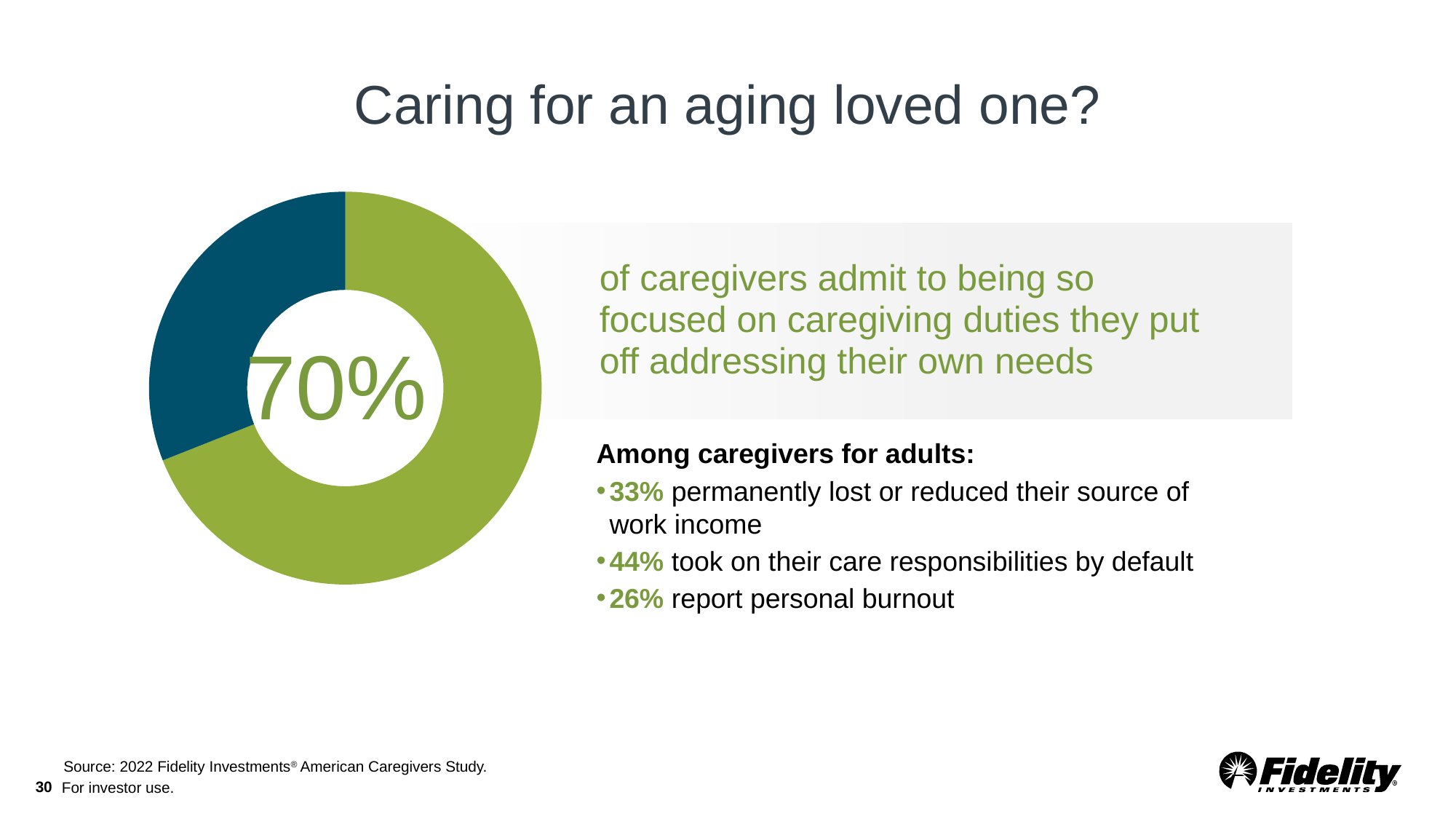
How many slices does the donut chart have? 2 Is the green slice of the donut chart greater or less than half of the whole? greater What kind of chart is shown on the left of the slide? Donut (pie) chart Is the dark blue slice of the donut chart greater or less than half of the whole? less What colour is the larger slice of the donut chart? Green What percentage is displayed in the centre of the donut chart? 70% Which slice of the donut chart is larger, the green one or the dark blue one? The green one What share of the donut chart does the green slice represent? 70% According to the slide, what does the 70% in the donut chart represent? Caregivers who admit to being so focused on caregiving duties they put off addressing their own needs